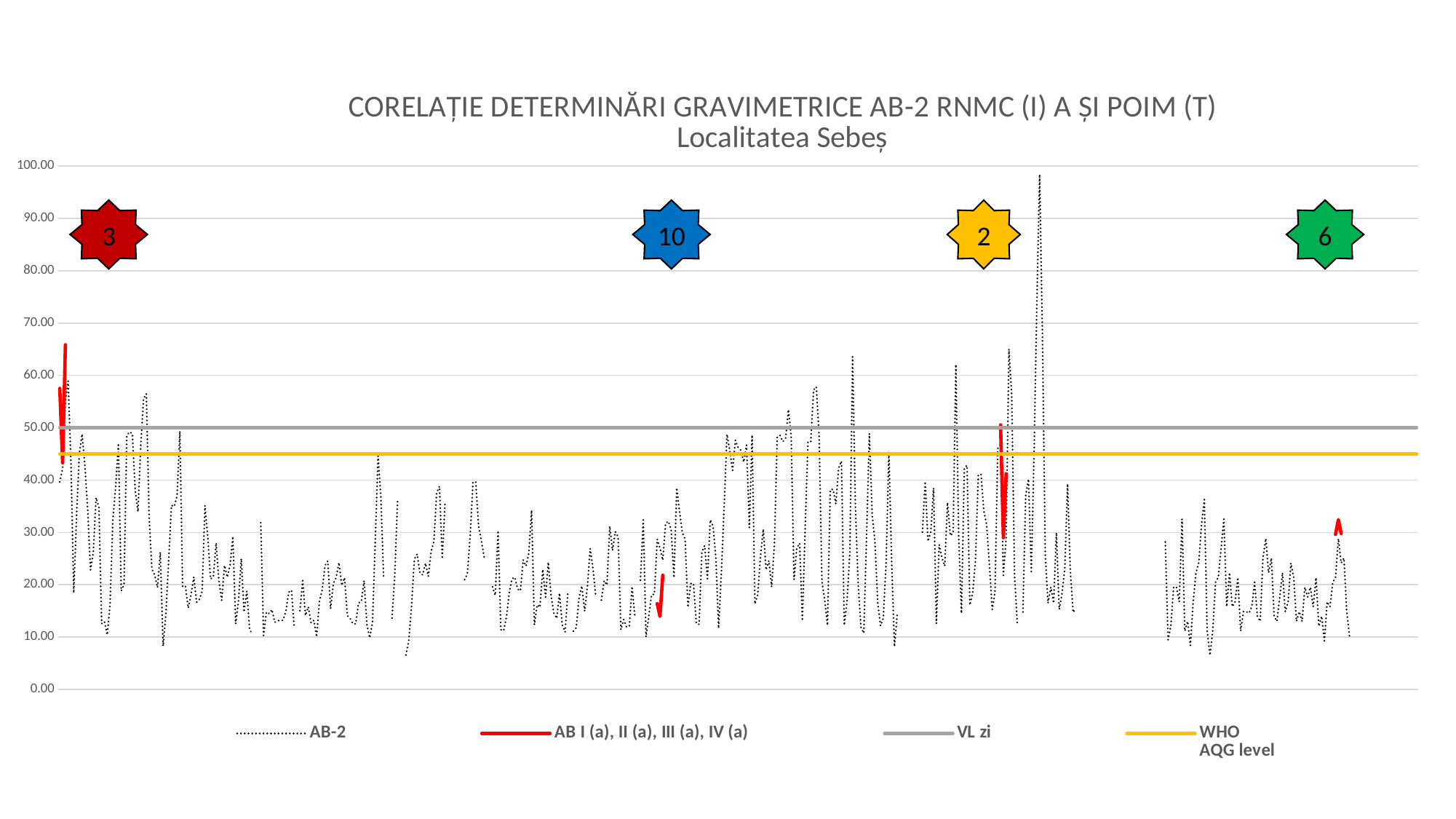
Which series is drawn as a red line? AB I (a), II (a), III (a), IV (a) How many series does the legend list? 4 Is the lowest point of the AB-2 series greater or less than 10? less Is the highest point of the red AB I (a), II (a), III (a), IV (a) series greater or less than 60? greater What kind of chart is shown on the slide? line chart Is the highest peak of the AB-2 series greater or less than 90? greater Which horizontal reference line is higher, VL zi or WHO AQG level? VL zi What is the maximum value shown on the y axis? 100.00 At what value does the VL zi line sit on the y axis? 50.00 Which locality is named in the chart title? Localitatea Sebeș